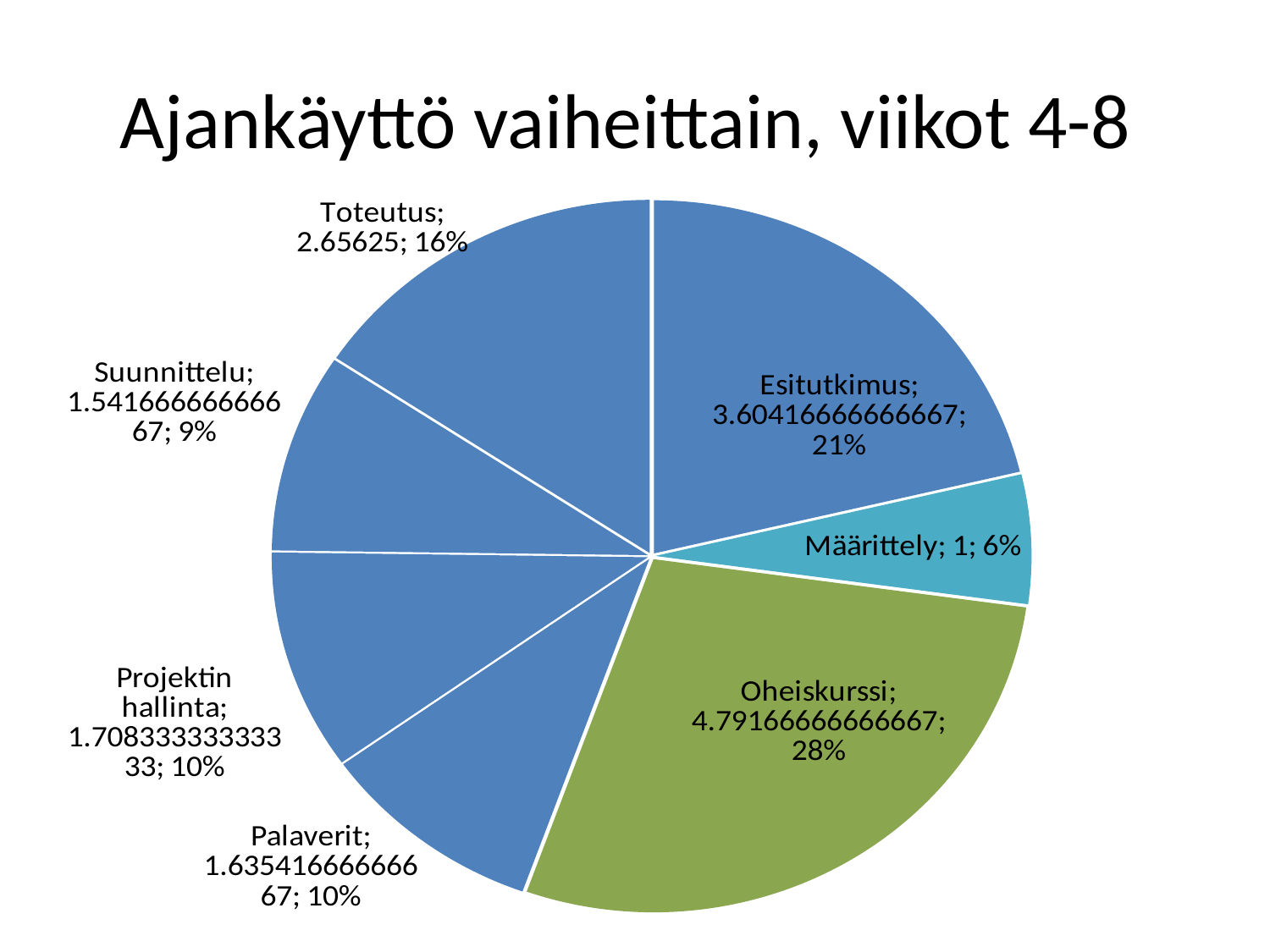
What is the title of the chart? Ajankäyttö vaiheittain, viikot 4-8 Which is larger, the slice for Esitutkimus or the slice for Toteutus? Esitutkimus What share of the pie does Suunnittelu represent? 9% Which category has the smallest slice of the pie? Määrittely How many slices does the pie chart have? 7 What is the value shown for Määrittely? 1 What kind of chart is shown on the slide? pie chart What share of the pie does Oheiskurssi represent? 28% What share of the pie does Esitutkimus represent? 21% Which category has the largest slice of the pie? Oheiskurssi What is the difference in percentage share between Oheiskurssi and Määrittely? 22% What is the value shown for Toteutus? 2.65625